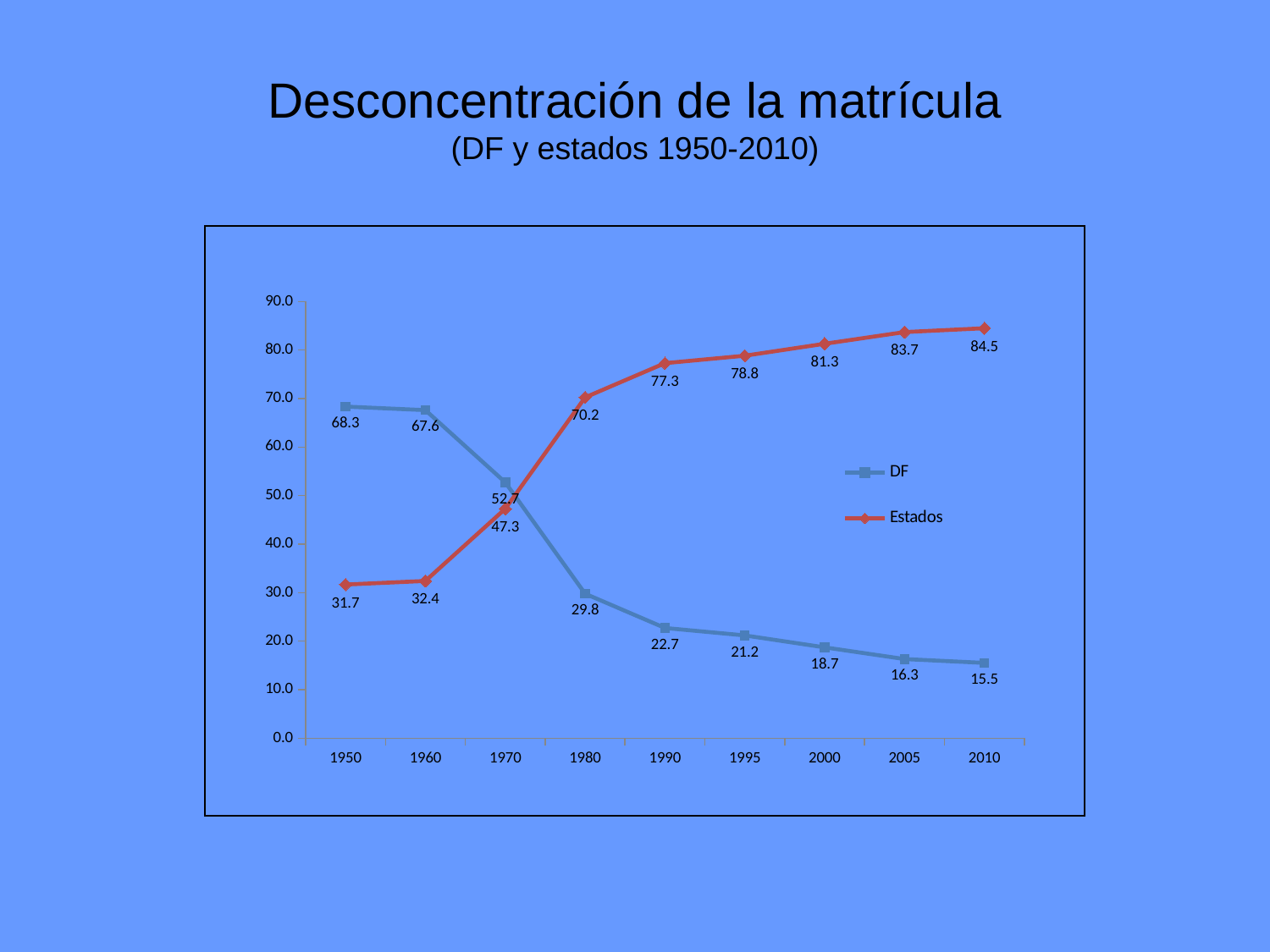
What is the value for DF in 1950? 68.3 Which series has the larger value in 1970, DF or Estados? DF What is the value for Estados in 1980? 70.2 How many series does the legend list? 2 How many years are shown on the x axis? 9 What is the title of the chart on the slide? Desconcentración de la matrícula (DF y estados 1950-2010) What kind of chart is shown on the slide? line chart What is the value for Estados in 2010? 84.5 In which year is the Estados series at its highest? 2010 What is the difference between the Estados and DF values in 2010? 69.0 Does the DF series rise or fall from 1950 to 2010? fall In which year is the DF series at its lowest? 2010